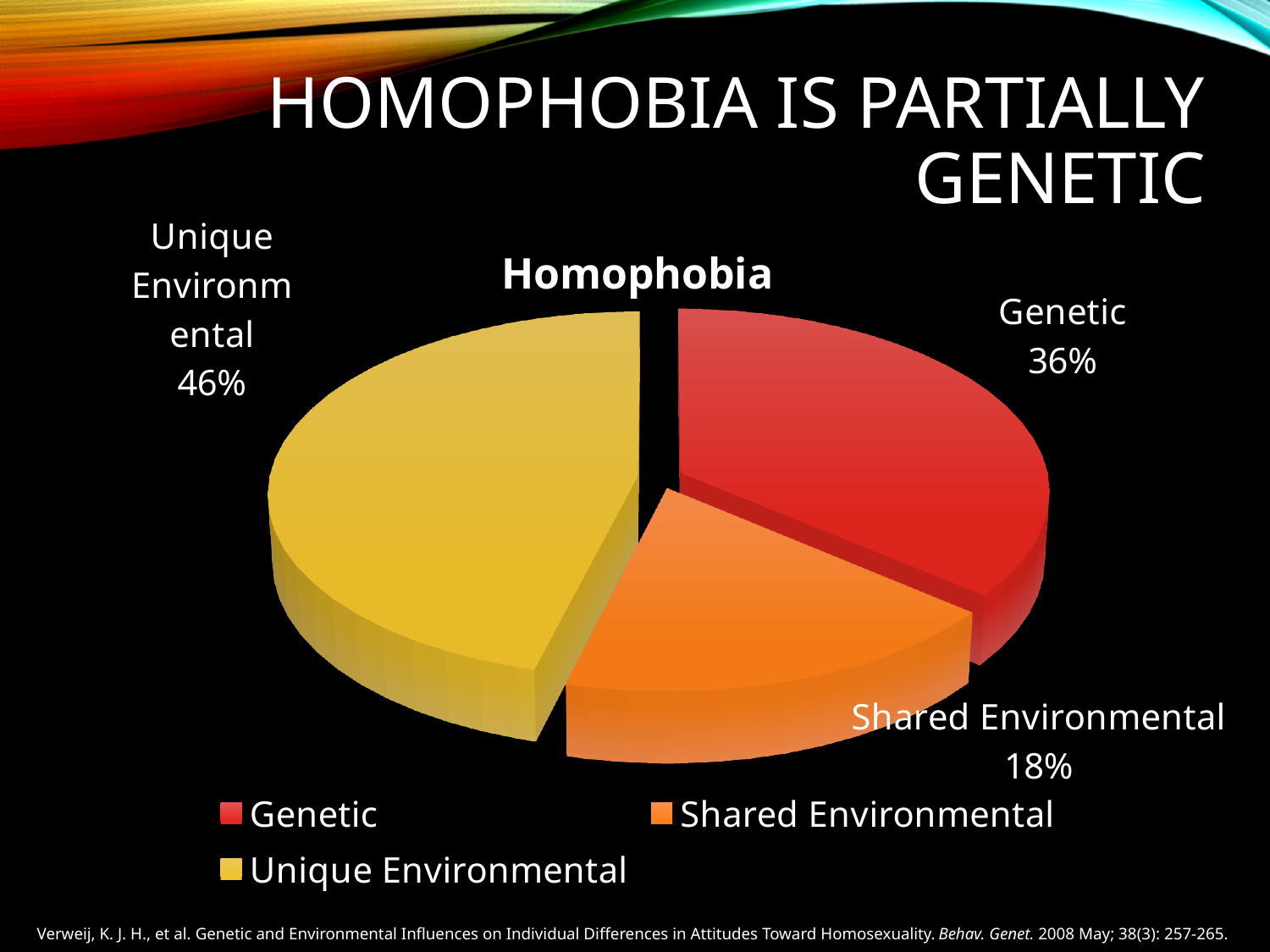
What is the chart's title? Homophobia How many slices does the pie chart have? 3 What percentage of the pie is Shared Environmental? 18% What is the difference in percentage points between Unique Environmental and Genetic? 10 What type of chart is shown on the slide? Pie chart What percentage of the pie is Genetic? 36% What percentage of the pie is Unique Environmental? 46% Which slice of the pie is the smallest? Shared Environmental Which is larger, Genetic or Shared Environmental? Genetic Which slice of the pie is the largest? Unique Environmental What colour is the Genetic slice? Red How many entries does the legend list? 3